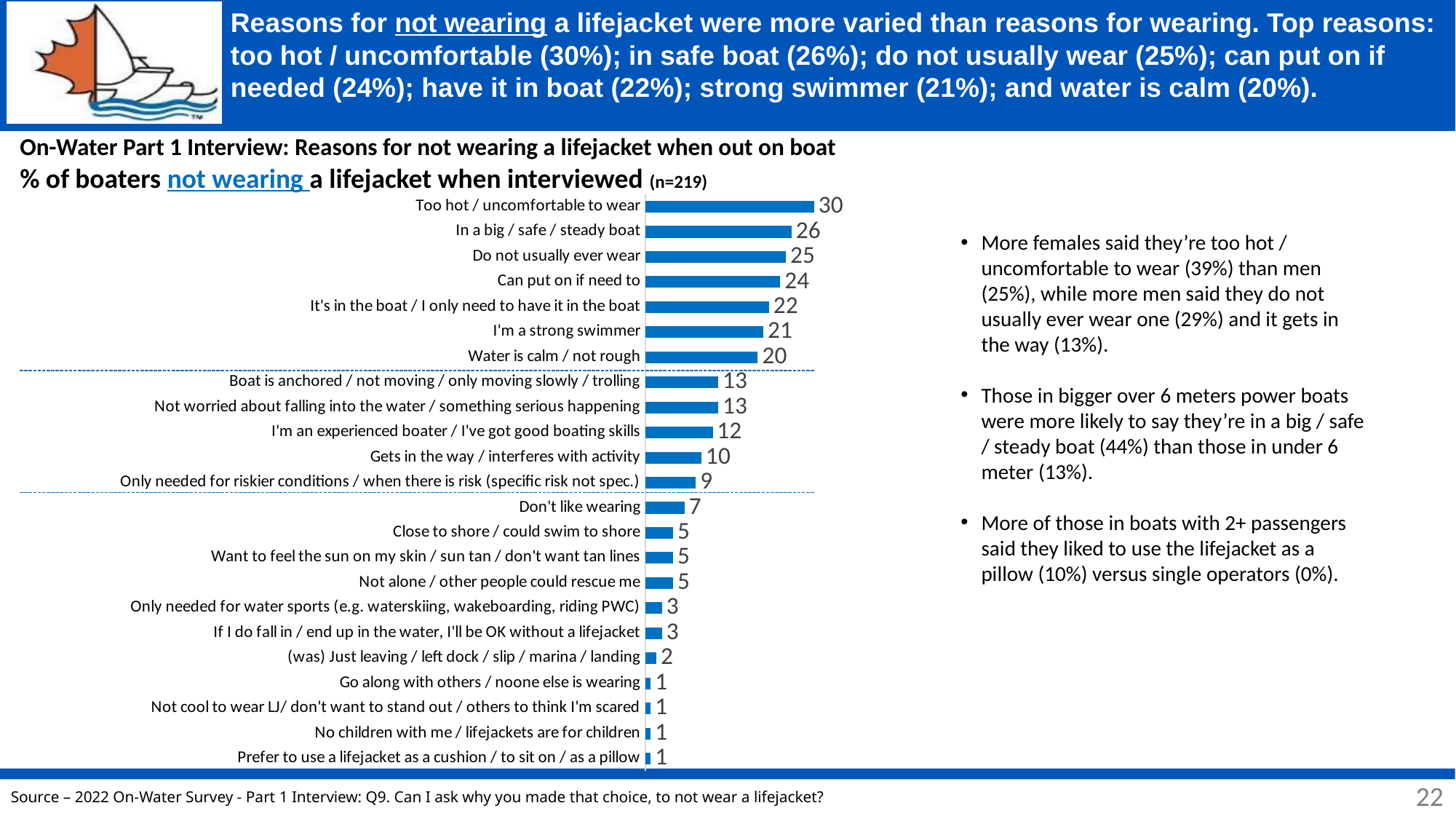
What is the sample size (n) shown in the chart subtitle? n=219 What is the value for "Gets in the way / interferes with activity"? 10 What is the difference between "In a big / safe / steady boat" and "Water is calm / not rough"? 6 What is the difference between "Can put on if need to" and "Only needed for riskier conditions / when there is risk (specific risk not spec.)"? 15 Which reason has the highest value? Too hot / uncomfortable to wear What is the value for "Don't like wearing"? 7 What is the value for "Too hot / uncomfortable to wear"? 30 How many reasons (categories) are shown in the chart? 23 What is the value for "I'm a strong swimmer"? 21 Which is larger: "Close to shore / could swim to shore" or "(was) Just leaving / left dock / slip / marina / landing"? Close to shore / could swim to shore Which is larger: "Do not usually ever wear" or "I'm an experienced boater / I've got good boating skills"? Do not usually ever wear What kind of chart is shown on the slide? Bar chart